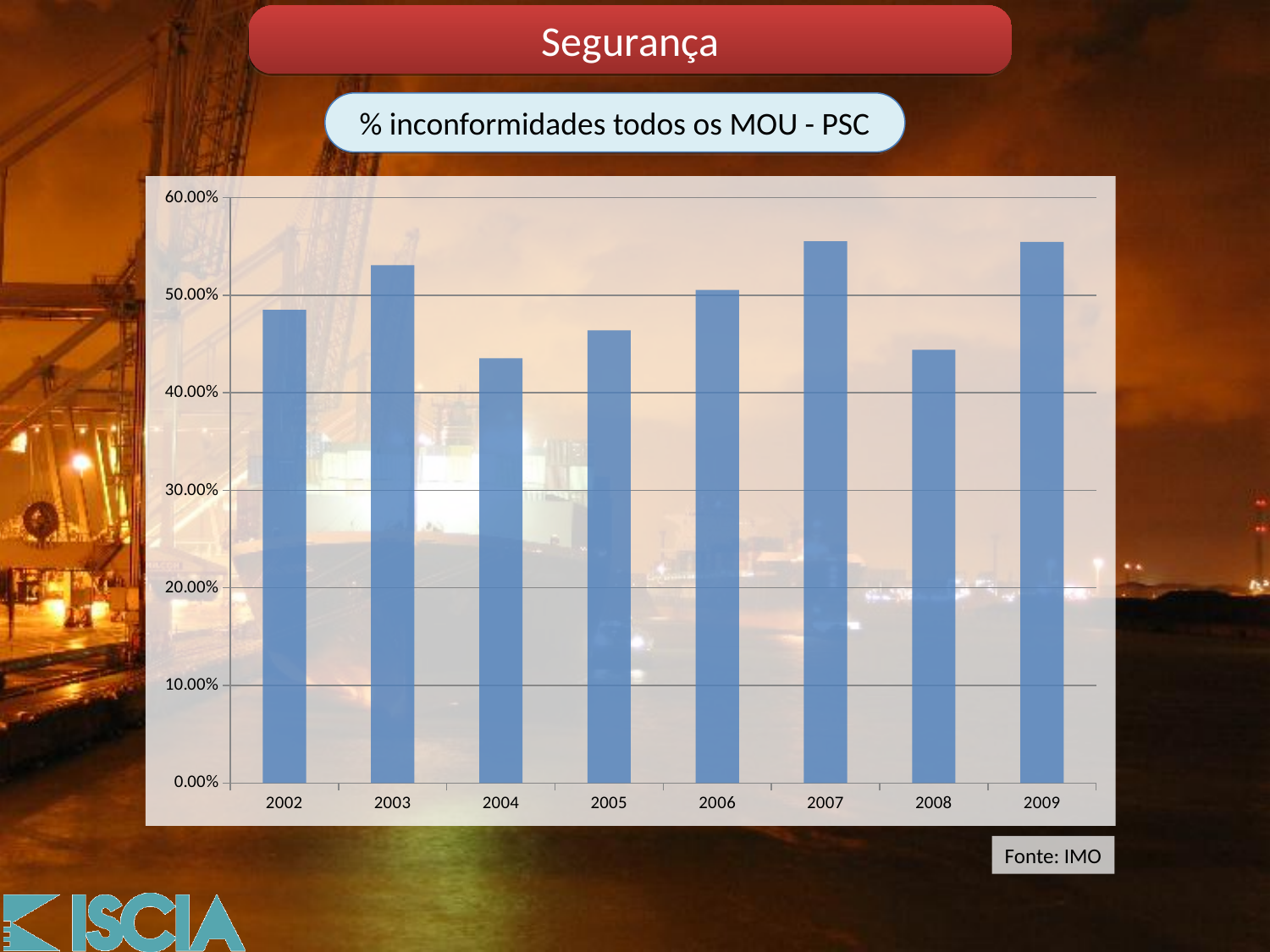
How many years are shown on the x axis of the chart? 8 What source is cited for the chart? IMO Is the value for 2004 greater or less than 50.00%? less What kind of chart is shown on the slide? bar chart Is the value for 2007 greater or less than 50.00%? greater What is the title shown above the chart? % inconformidades todos os MOU - PSC Which year has the larger value, 2007 or 2008? 2007 Is the value for 2004 greater or less than 40.00%? greater Which year has the larger value, 2003 or 2004? 2003